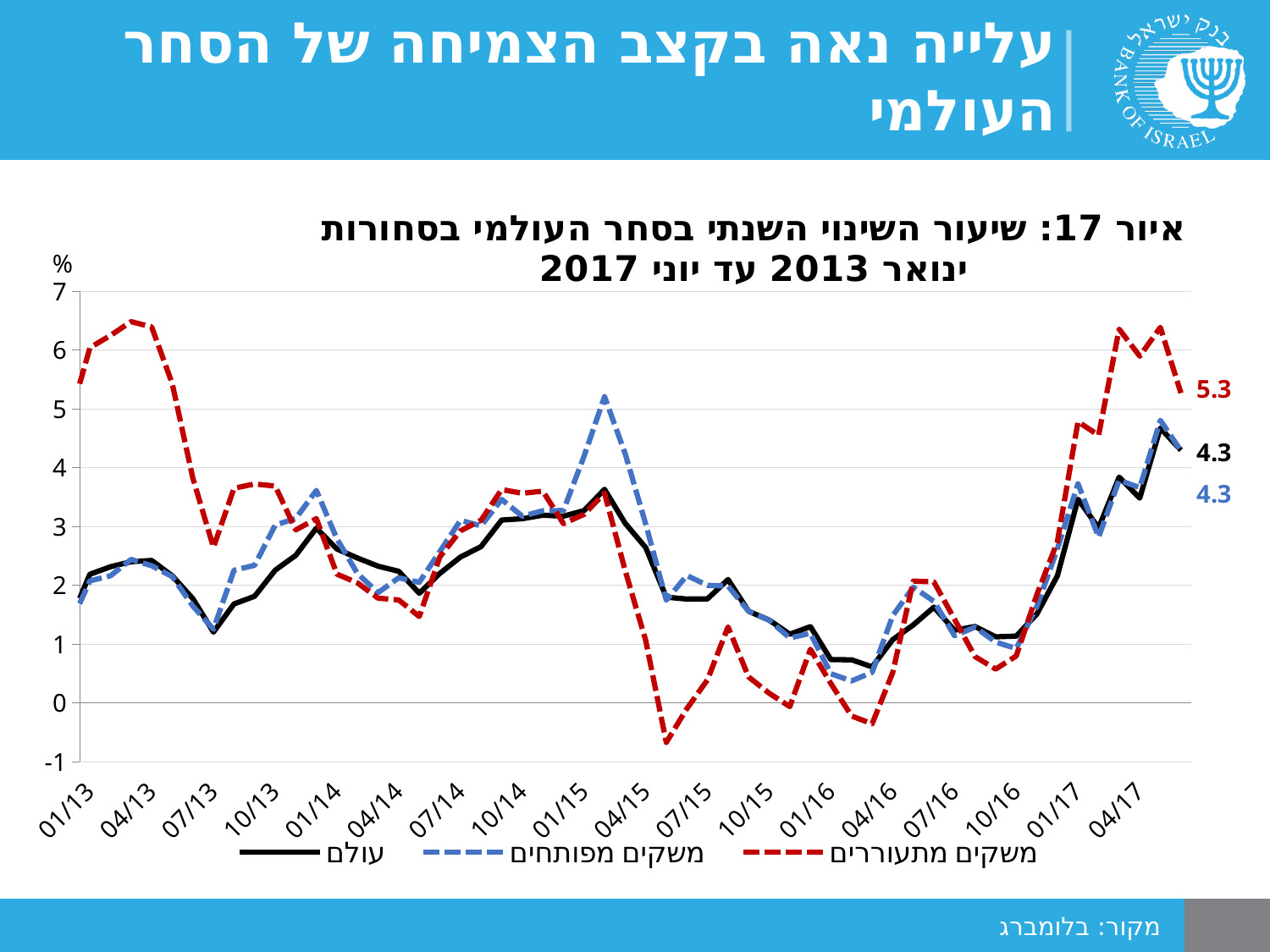
What source is cited at the bottom of the slide? בלומברג Is the value for עולם at 07/13 greater or less than 2? less What is the difference between the final labelled values of משקים מתעוררים and עולם? 1.0 Is the value for משקים מתעוררים at 04/13 greater or less than 6? greater What is the final labelled value for the משקים מפותחים (developed economies) series? 4.3 What kind of chart is shown on the slide? line chart What is the final labelled value for the עולם (world) series? 4.3 What is the final labelled value for the משקים מתעוררים (emerging economies) series? 5.3 Which series has the highest labelled value at the end of the chart? משקים מתעוררים Do the series rise or fall between 10/16 and 04/17? rise How many series does the legend list? 3 Is the value for משקים מתעוררים at 04/15 greater or less than 0? greater